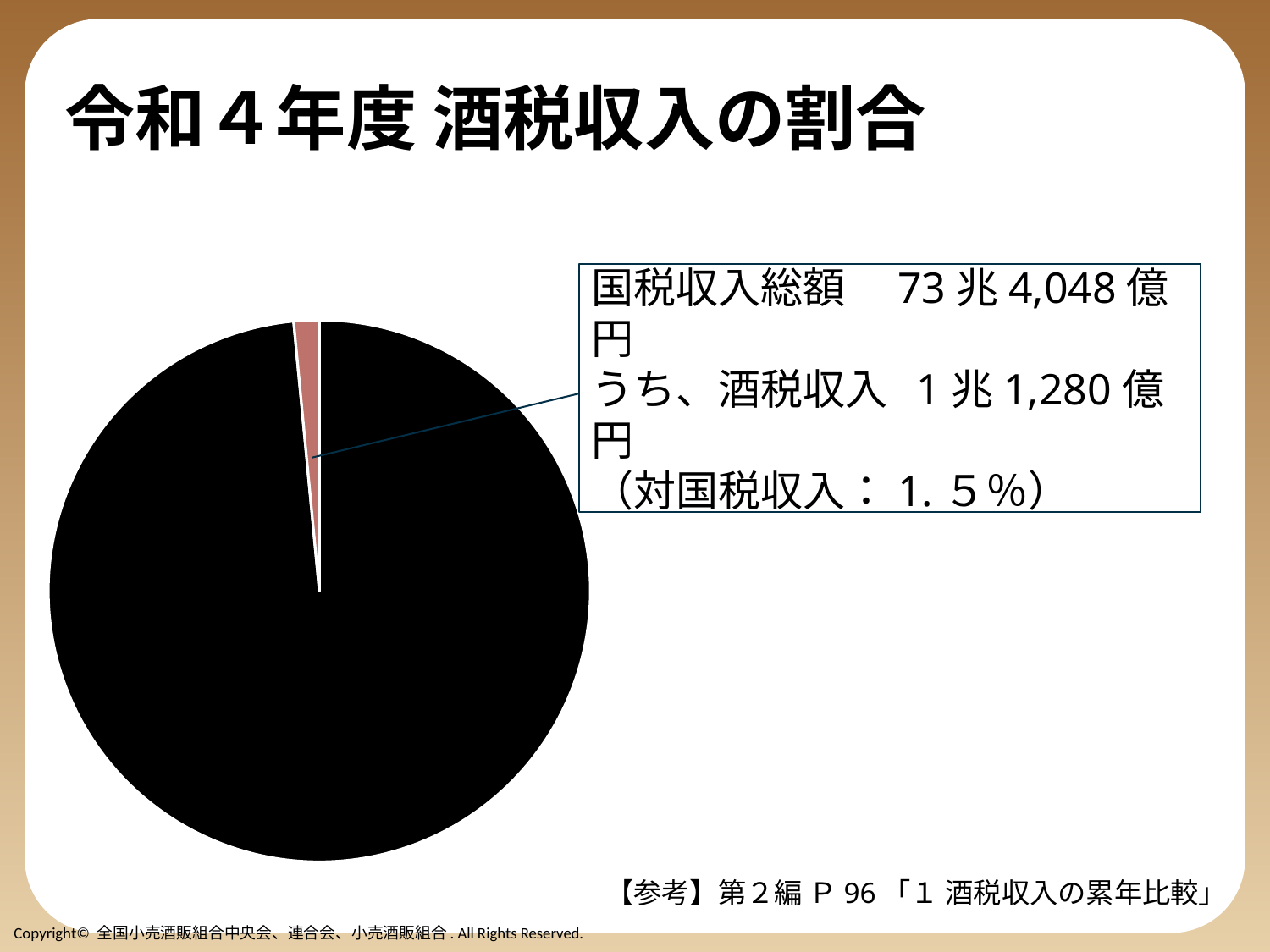
Is the liquor tax (酒税収入) slice the larger or the smaller slice of the pie? Smaller What is the total national tax revenue (国税収入総額) shown in the callout? 73兆4,048億円 How many slices does the pie chart have? 2 What colour is the slice representing liquor tax revenue (酒税収入)? Pink According to the callout, what share of national tax revenue does liquor tax revenue (酒税収入) represent? 1.5% What kind of chart is shown on the slide? Pie chart What is the liquor tax revenue (酒税収入) shown in the callout? 1兆1,280億円 Which slice of the pie is the largest: the black slice or the pink slice pointed to by the callout? The black slice What is the title of the slide? 令和４年度 酒税収入の割合